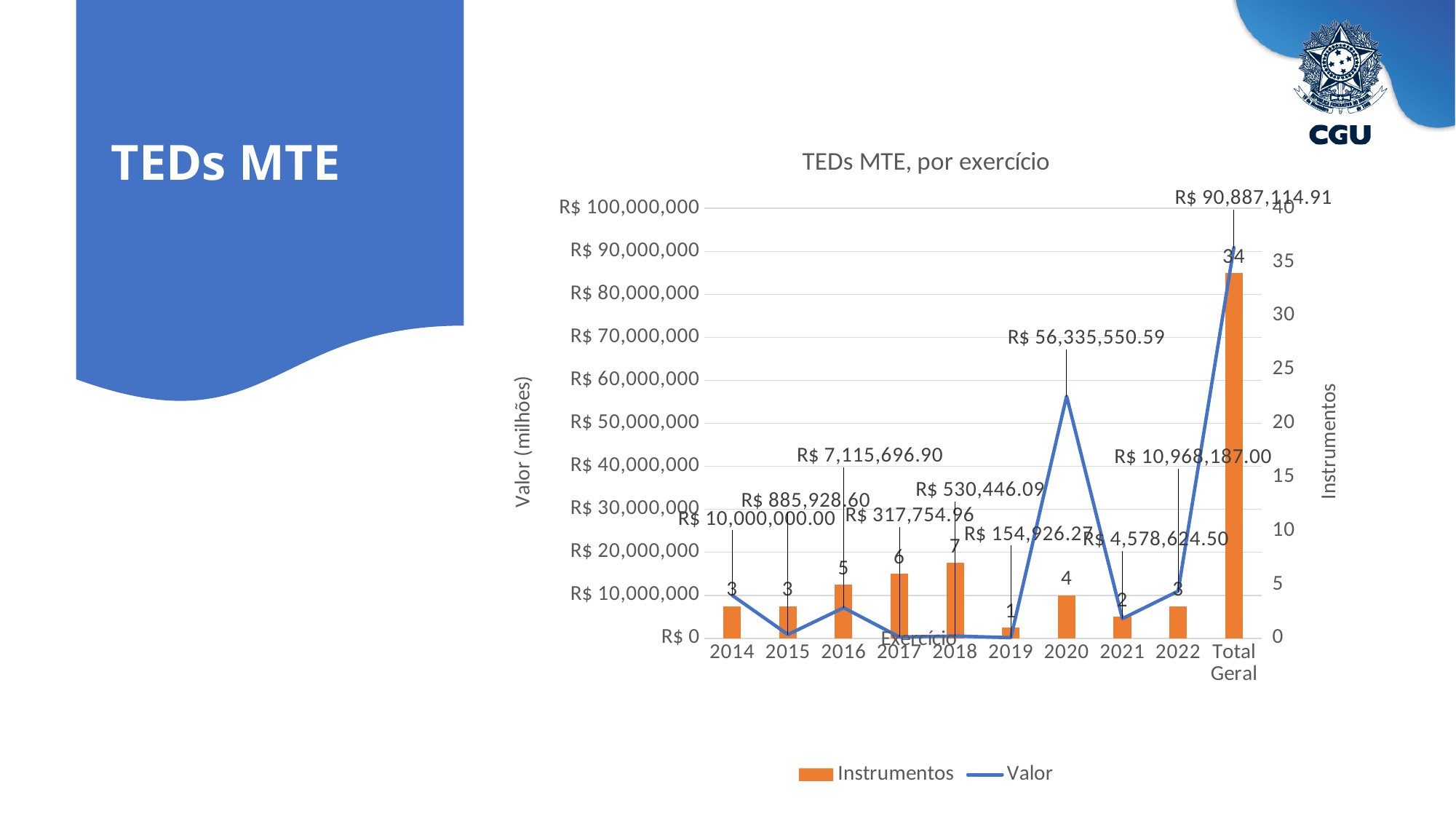
What is the Instrumentos value for Total Geral? 34 What is the title of the chart? TEDs MTE, por exercício Excluding Total Geral, which year has the highest Valor? 2020 How many series does the legend list? 2 Which series is drawn as a line? Valor How many categories are shown on the x axis? 10 Which is larger, the Valor for 2021 or the Valor for 2022? 2022 What is the Instrumentos value for 2018? 7 What is the Valor for 2020? R$ 56,335,550.59 What is the Valor for 2016? R$ 7,115,696.90 What is the difference in Instrumentos between 2018 and 2019? 6 Excluding Total Geral, which year has the lowest Instrumentos value? 2019